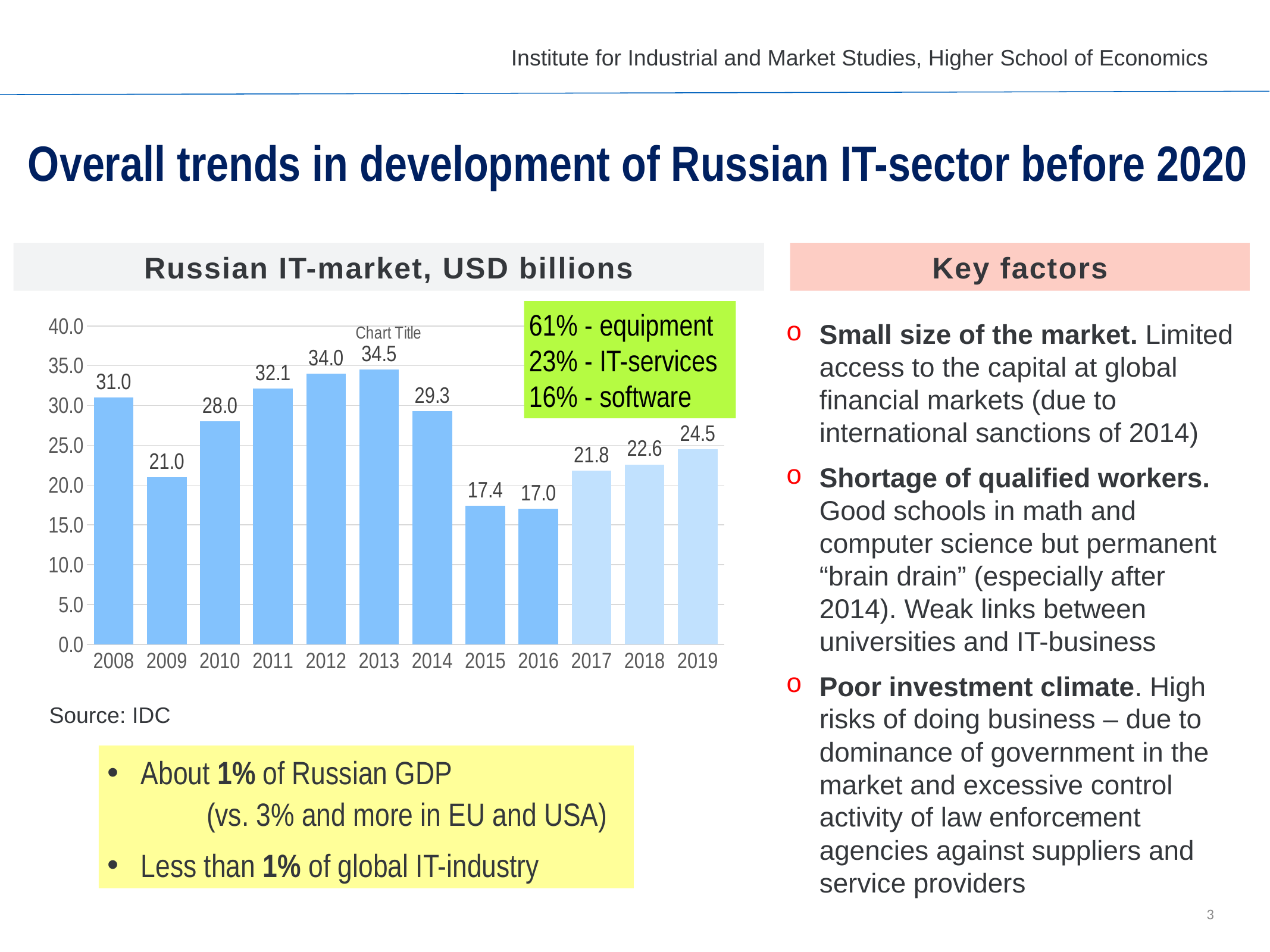
What kind of chart is used to show the Russian IT-market? bar chart What is the value of the Russian IT-market for 2016? 17.0 Do the values in the Russian IT-market chart rise or fall from 2017 to 2019? rise What is the value of the Russian IT-market for 2019? 24.5 Which is larger in the Russian IT-market chart, the value for 2008 or the value for 2014? 2008 Is the value for 2017 in the Russian IT-market chart greater or less than 25.0? less What is the source cited below the Russian IT-market chart? IDC How many years are shown on the x axis of the Russian IT-market chart? 12 What is the value of the Russian IT-market for 2013? 34.5 What is the difference between the values for 2013 and 2016 in the Russian IT-market chart? 17.5 Which year has the highest value in the Russian IT-market chart? 2013 Which year has the lowest value in the Russian IT-market chart? 2016